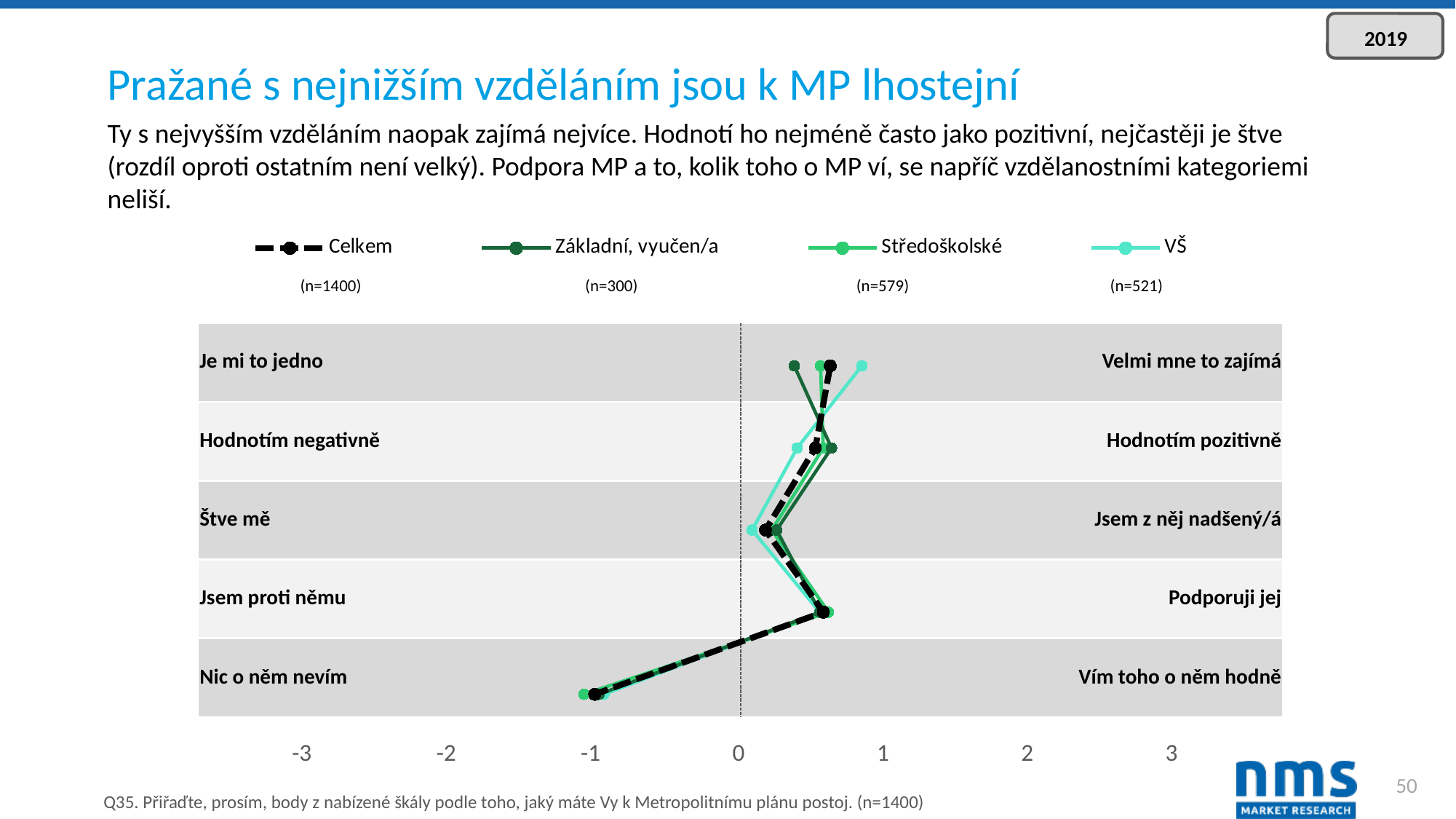
Is the VŠ value for the row 'Je mi to jedno / Velmi mne to zajímá' greater or less than 0? greater What is the sample size (n) shown for the Celkem series? n=1400 In the row 'Hodnotím negativně / Hodnotím pozitivně', which series has the higher value: Základní, vyučen/a or VŠ? Základní, vyučen/a How many series does the legend list? 4 How many statement pairs (rows) are plotted on the chart? 5 What kind of chart is shown on the slide? line chart In the row 'Štve mě / Jsem z něj nadšený/á', which series has the lowest value? VŠ In the row 'Je mi to jedno / Velmi mne to zajímá', which series has the lowest value? Základní, vyučen/a Is the Celkem value for the row 'Nic o něm nevím / Vím toho o něm hodně' greater or less than 0? less What is the sample size (n) shown for the VŠ series? n=521 In the row 'Je mi to jedno / Velmi mne to zajímá', which series has the higher value: VŠ or Základní, vyučen/a? VŠ Is the Celkem value for the row 'Jsem proti němu / Podporuji jej' greater or less than 1? less